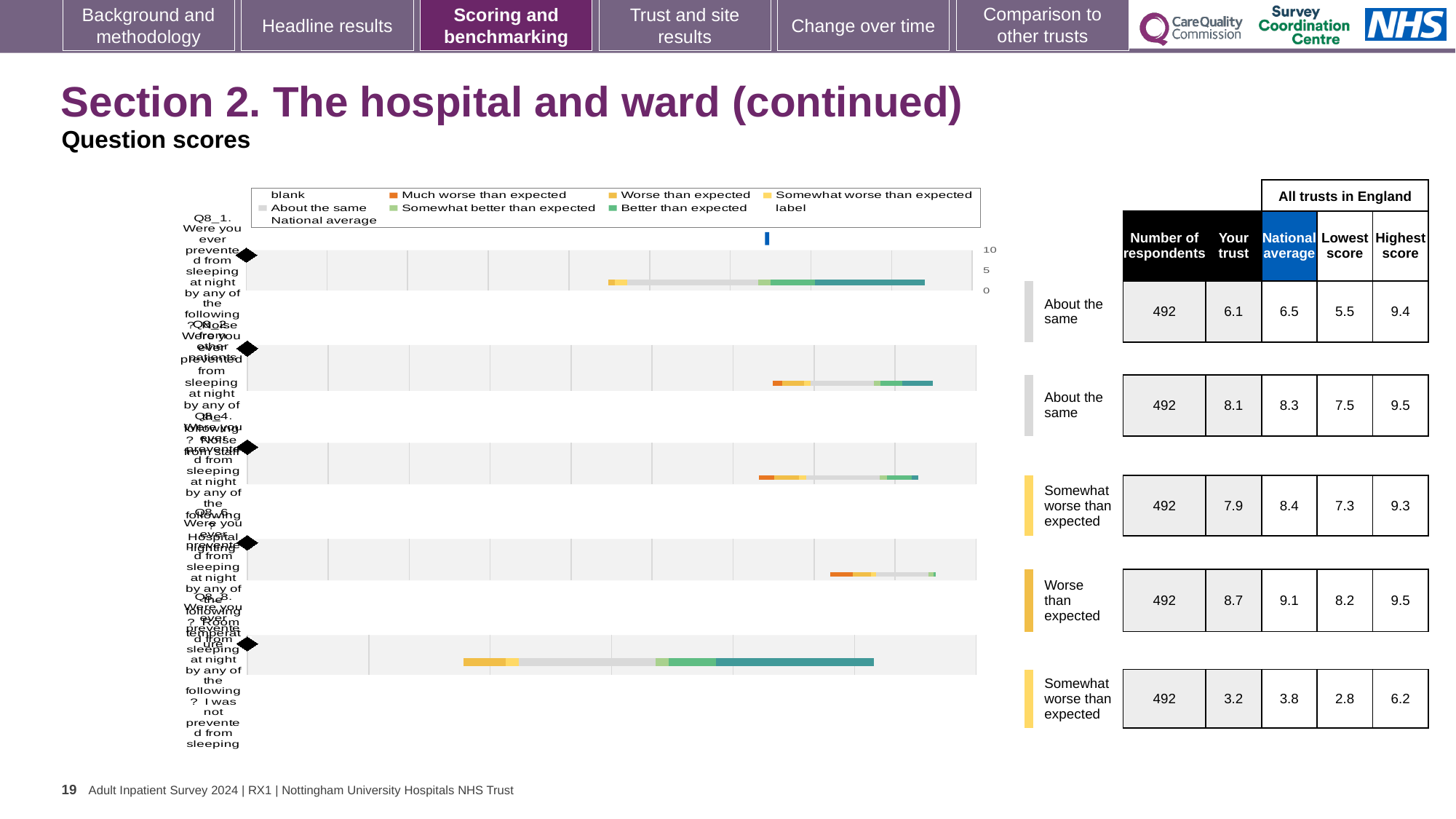
In the table beside the chart, which row has the highest 'Your trust' score? the fourth row (Worse than expected), 8.7 In the table beside the chart, what is the national average for the row labelled 'Worse than expected'? 9.1 How many question bars are plotted in the chart? 5 In the table beside the chart, what is the difference between the national average and the 'Your trust' score for the row labelled 'Worse than expected'? 0.4 In the table beside the chart, what is the 'Your trust' score for the first row? 6.1 What kind of chart is shown on the slide? bar chart In the chart legend, which entry is shown in dark orange? Much worse than expected How many entries does the chart legend list? 9 In the table beside the chart, how many respondents are listed for the second row? 492 In the table beside the chart, which row has the lowest 'Your trust' score? the fifth row (Somewhat worse than expected), 3.2 In the table beside the chart, what is the highest score for the last row? 6.2 In the table beside the chart, for the third row, which is larger: the 'Your trust' score or the national average? National average